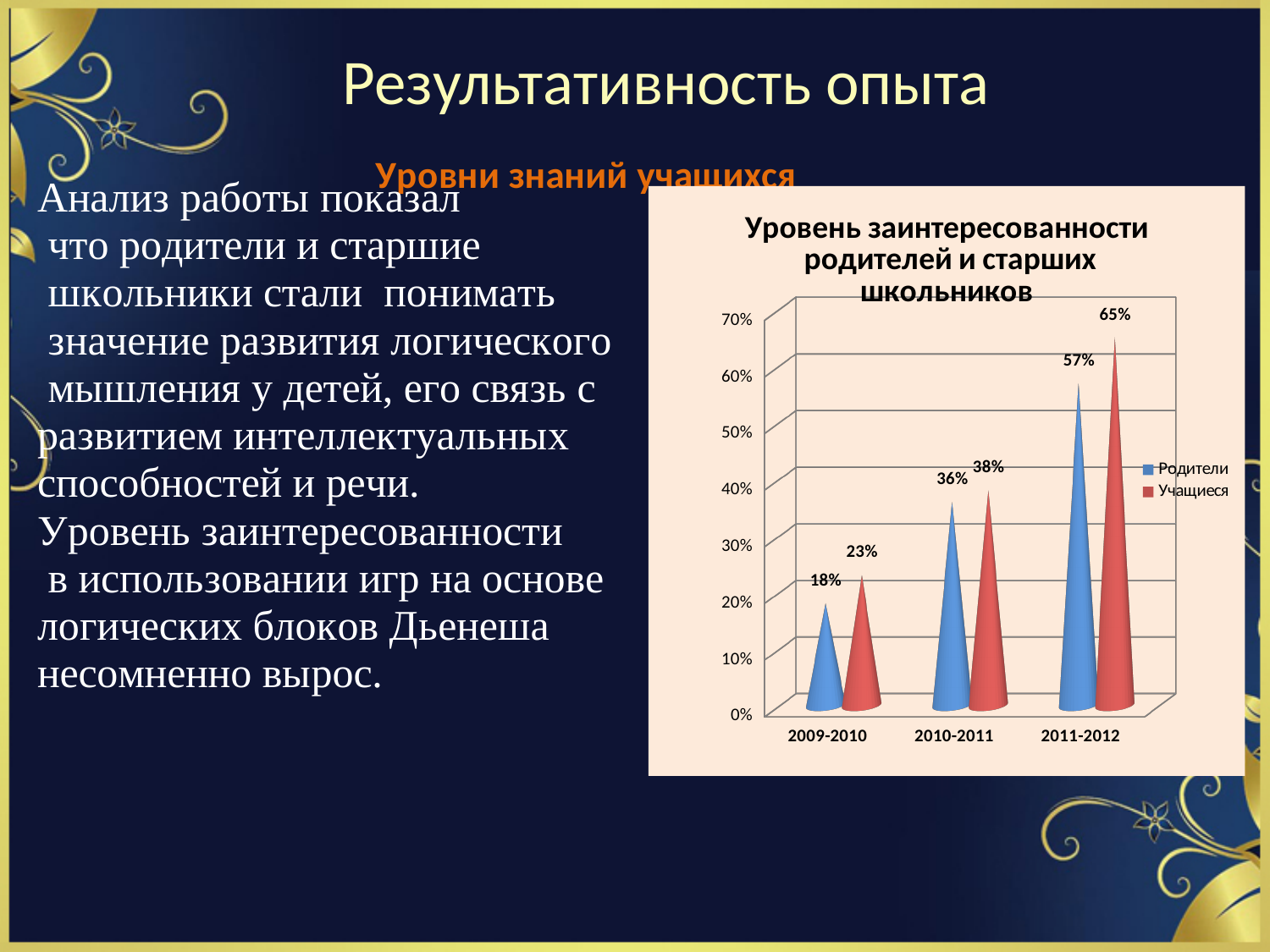
How many year categories are shown on the x axis? 3 In which year is the value for Учащиеся lowest? 2009-2010 How many series does the legend list? 2 What kind of chart is shown? bar chart Which is larger in 2009-2010, Родители or Учащиеся? Учащиеся In which year is the value for Родители highest? 2011-2012 Which colour represents Учащиеся in the legend? red Do the values for Родители rise or fall from 2009-2010 to 2011-2012? rise What is the difference between Учащиеся and Родители in 2011-2012? 8% What is the value for Учащиеся in 2011-2012? 65% What is the value for Учащиеся in 2010-2011? 38% What is the value for Родители in 2009-2010? 18%